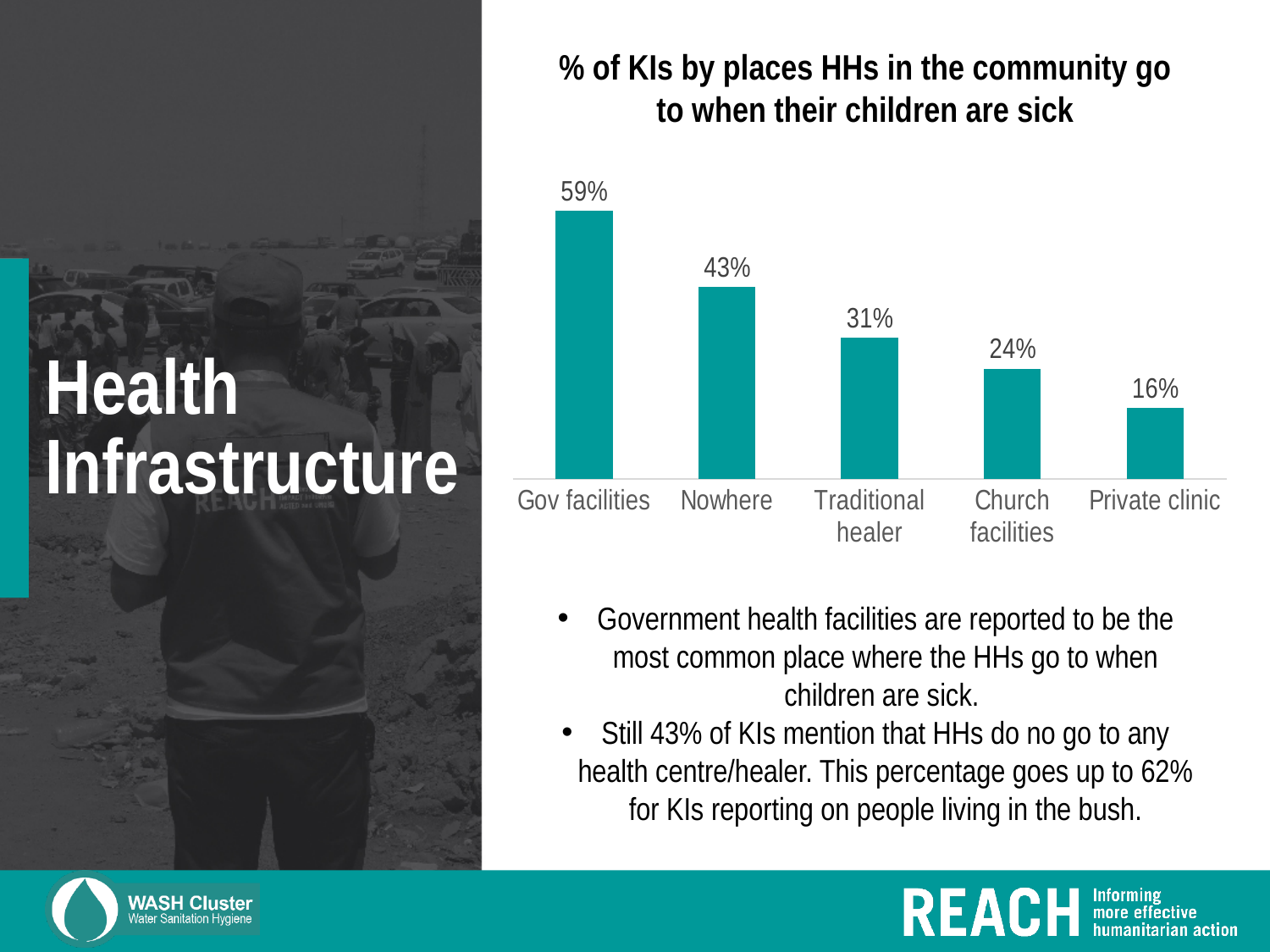
What kind of chart is shown on the slide? Bar chart What is the difference between the values for Church facilities and Private clinic? 8% What percentage of KIs reported Gov facilities as the place HHs go when their children are sick? 59% What percentage is shown for Traditional healer? 31% What is the difference between the values for Gov facilities and Nowhere? 16% What is the value shown for Nowhere? 43% How many categories are shown in the chart? 5 Which category has the lowest percentage of KIs? Private clinic Which category has the highest percentage of KIs? Gov facilities Which is larger, the value for Traditional healer or the value for Church facilities? Traditional healer What is the title of the chart? % of KIs by places HHs in the community go to when their children are sick What is the value for Private clinic? 16%